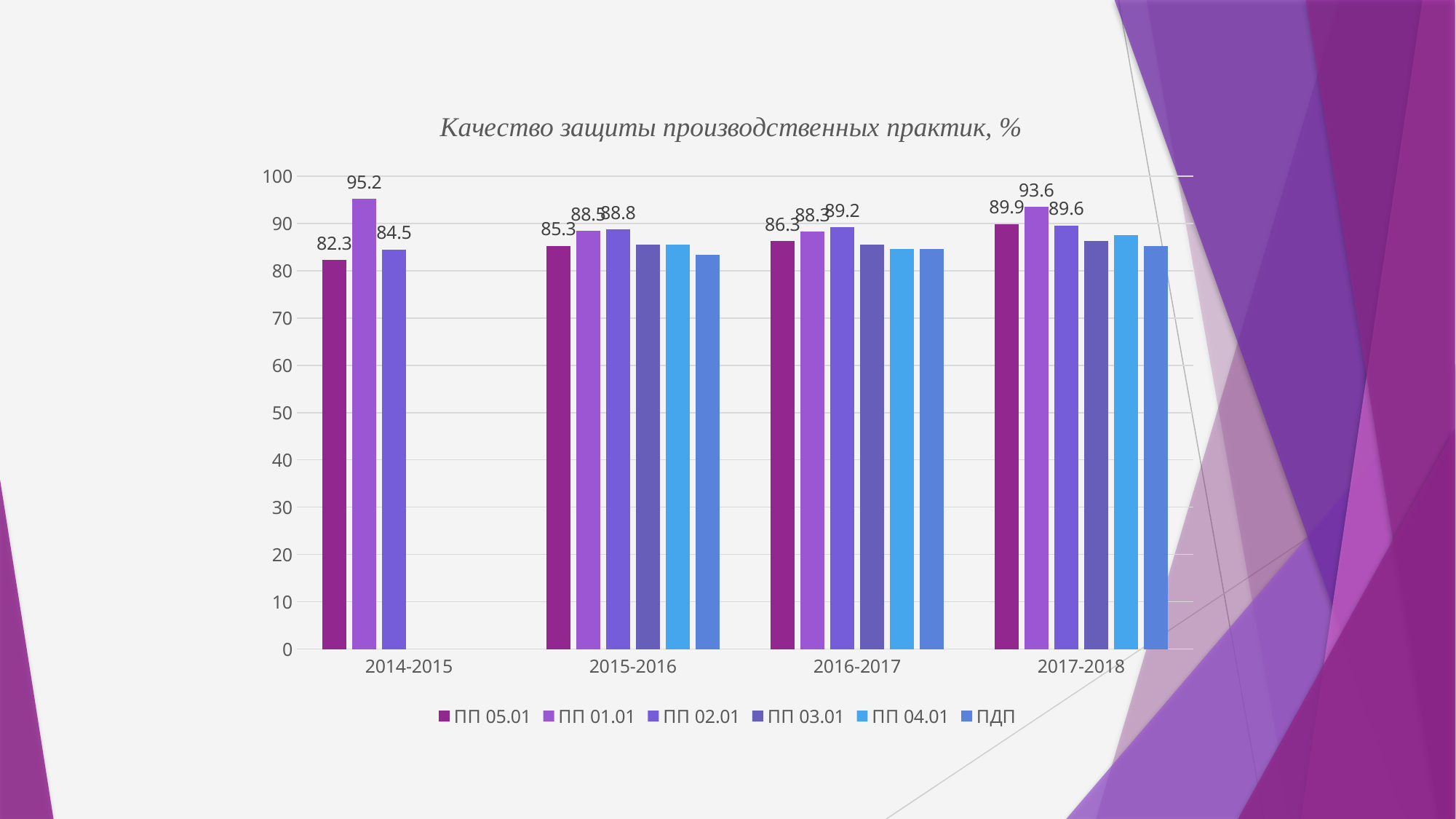
How many academic-year categories are shown on the x axis? 4 What is the difference between ПП 01.01 and ПП 05.01 in 2014-2015? 12.9 What kind of chart is shown on the slide? bar chart Does the value for ПП 05.01 rise or fall from 2014-2015 to 2017-2018? rise What is the value for ПП 02.01 in 2016-2017? 89.2 What is the value for ПП 05.01 in 2017-2018? 89.9 What is the value for ПП 02.01 in 2014-2015? 84.5 What is the value for ПП 01.01 in 2014-2015? 95.2 Is the value for ПДП in 2015-2016 greater or less than 90? less How many series does the legend list? 6 Which series has the highest value in 2014-2015? ПП 01.01 Which is larger: the value for ПП 01.01 in 2014-2015 or in 2017-2018? 2014-2015